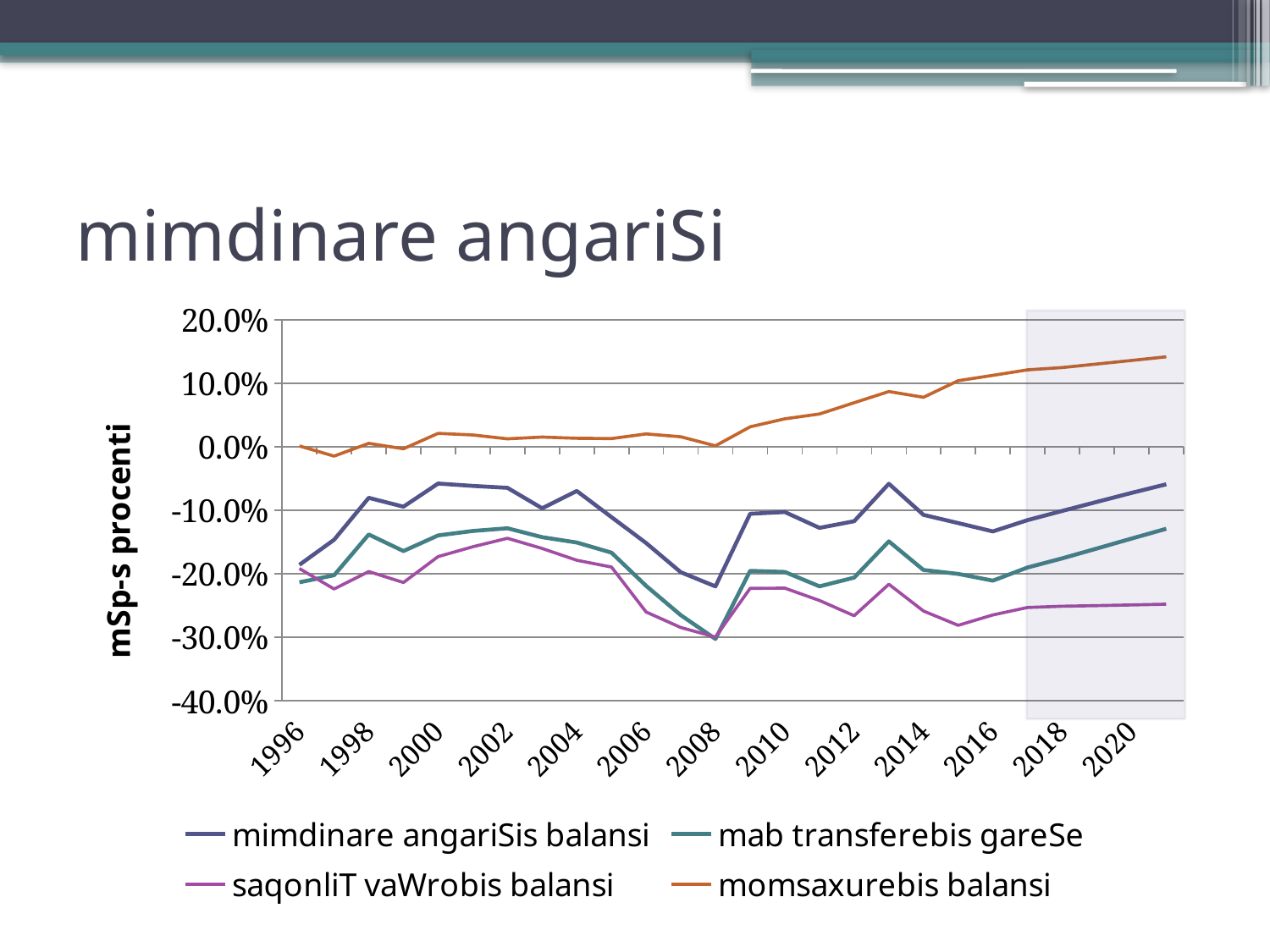
Is the value for mab transferebis gareSe in 2002 greater or less than -20.0%? greater What kind of chart is shown on the slide? line chart Is the value for saqonliT vaWrobis balansi in 2008 greater or less than -20.0%? less What is the title of the chart? mimdinare angariSi In 2020, which series has the higher value: momsaxurebis balansi or saqonliT vaWrobis balansi? momsaxurebis balansi Is the value for mimdinare angariSis balansi in 2013 greater or less than -10.0%? greater How many series does the legend list? 4 Which series has the lowest value in 2016? saqonliT vaWrobis balansi Does the momsaxurebis balansi line rise or fall from 2008 to 2020? rise What is the label on the vertical axis? mSp-s procenti Which series has the highest values across the whole chart? momsaxurebis balansi